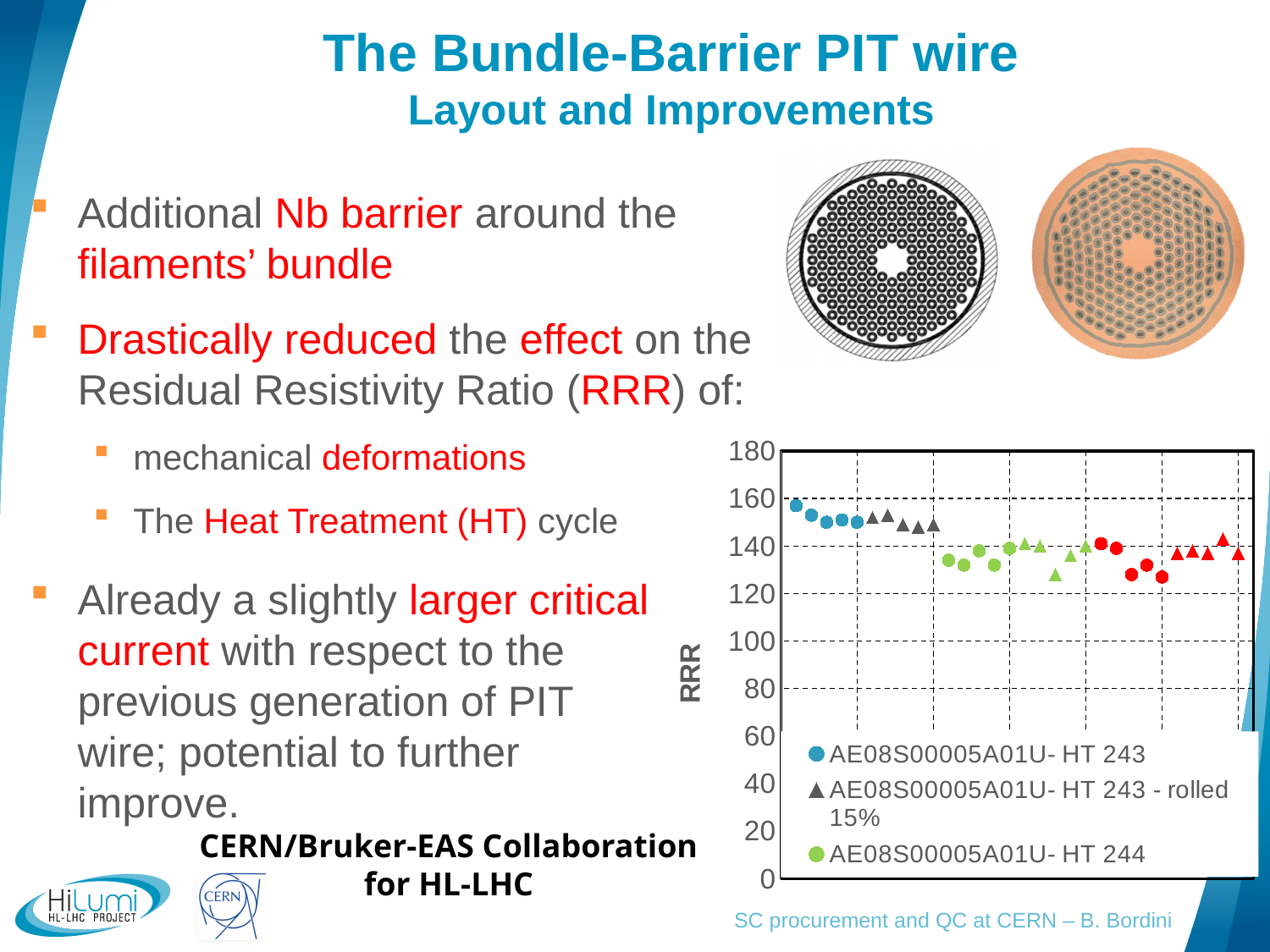
Are the RRR values for the AE08S00005A01U- HT 243 series (blue circles) greater or less than 140? greater What is the label on the vertical axis of the chart? RRR What is the highest value shown on the vertical axis of the chart? 180 How many series does the chart's legend list? 3 Are the RRR values for the AE08S00005A01U- HT 244 series (green circles) greater or less than 160? less Which marker shape is used for the AE08S00005A01U- HT 243 - rolled 15% series? triangle Are the RRR values for the AE08S00005A01U- HT 243 - rolled 15% series (grey triangles) greater or less than 140? greater Which series has higher RRR values: AE08S00005A01U- HT 243 (blue circles) or AE08S00005A01U- HT 244 (green circles)? AE08S00005A01U- HT 243 What kind of chart is shown on the slide? scatter chart Moving from left to right across the chart, do the RRR values generally rise or fall? fall